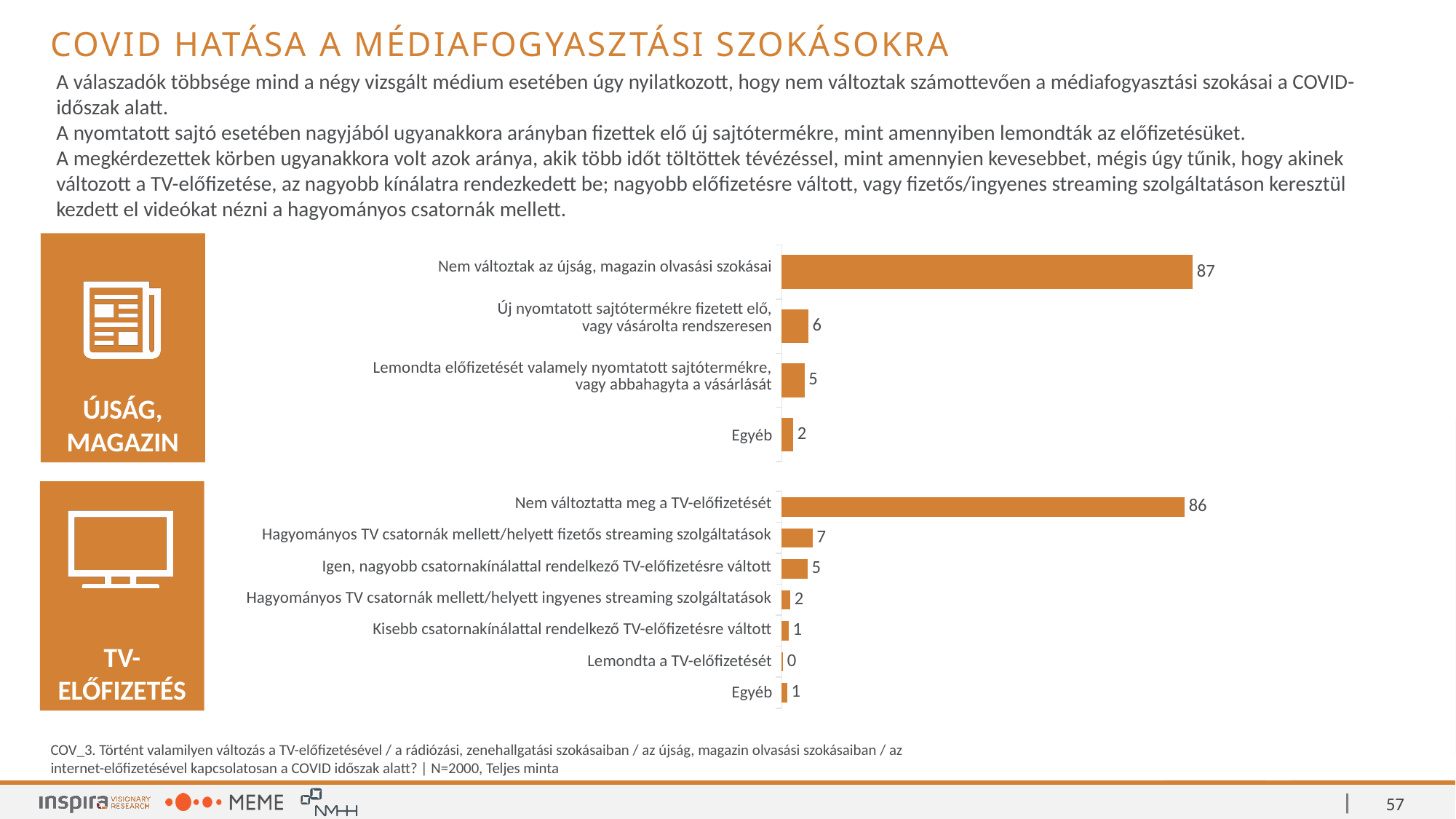
In the ÚJSÁG, MAGAZIN chart, what is the difference between "Új nyomtatott sajtótermékre fizetett elő, vagy vásárolta rendszeresen" and "Egyéb"? 4 How many categories are shown in the ÚJSÁG, MAGAZIN chart? 4 In the TV-ELŐFIZETÉS chart, what is the value for "Hagyományos TV csatornák mellett/helyett fizetős streaming szolgáltatások"? 7 In the TV-ELŐFIZETÉS chart, which category has the lowest value? Lemondta a TV-előfizetését In the TV-ELŐFIZETÉS chart, what is the value for "Nem változtatta meg a TV-előfizetését"? 86 In the ÚJSÁG, MAGAZIN chart, which category has the lowest value? Egyéb How many categories are shown in the TV-ELŐFIZETÉS chart? 7 In the ÚJSÁG, MAGAZIN chart, what is the value for "Lemondta előfizetését valamely nyomtatott sajtótermékre, vagy abbahagyta a vásárlását"? 5 In the TV-ELŐFIZETÉS chart, which is larger: "Hagyományos TV csatornák mellett/helyett fizetős streaming szolgáltatások" or "Igen, nagyobb csatornakínálattal rendelkező TV-előfizetésre váltott"? Hagyományos TV csatornák mellett/helyett fizetős streaming szolgáltatások What is the difference between the highest value in the ÚJSÁG, MAGAZIN chart and the highest value in the TV-ELŐFIZETÉS chart? 1 What type of chart is the TV-ELŐFIZETÉS chart? Bar chart In the ÚJSÁG, MAGAZIN chart, what is the value for "Nem változtak az újság, magazin olvasási szokásai"? 87